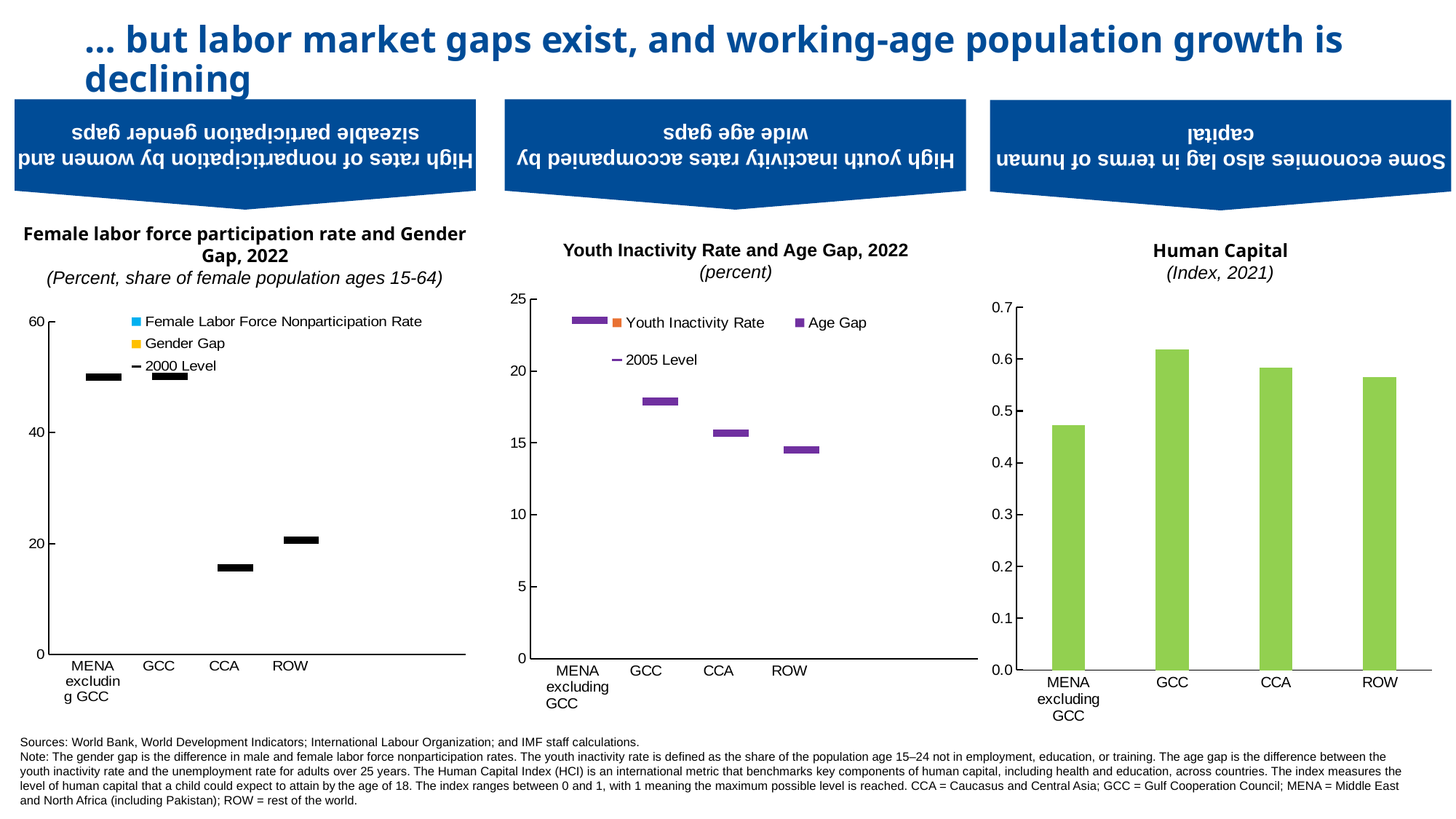
In the Human Capital chart, is the value for MENA excluding GCC greater or less than 0.5? less In the Human Capital chart, which category has the lowest index value? MENA excluding GCC How many series does the legend of the Youth Inactivity Rate and Age Gap, 2022 chart list? 3 What kind of chart is the Human Capital chart on the right? bar chart In the Female labor force participation rate and Gender Gap, 2022 chart, is the 2000 Level marker for CCA greater or less than 20? less In the Human Capital chart, is the value for GCC greater or less than 0.6? greater How many categories are shown in the Human Capital chart? 4 In the Human Capital chart, which category has the highest index value? GCC In the Youth Inactivity Rate and Age Gap, 2022 chart, do the 2005 Level markers rise or fall moving from MENA excluding GCC to ROW? fall How many series does the legend of the Female labor force participation rate and Gender Gap, 2022 chart list? 3 In the Human Capital chart, which is larger, the value for GCC or the value for CCA? GCC